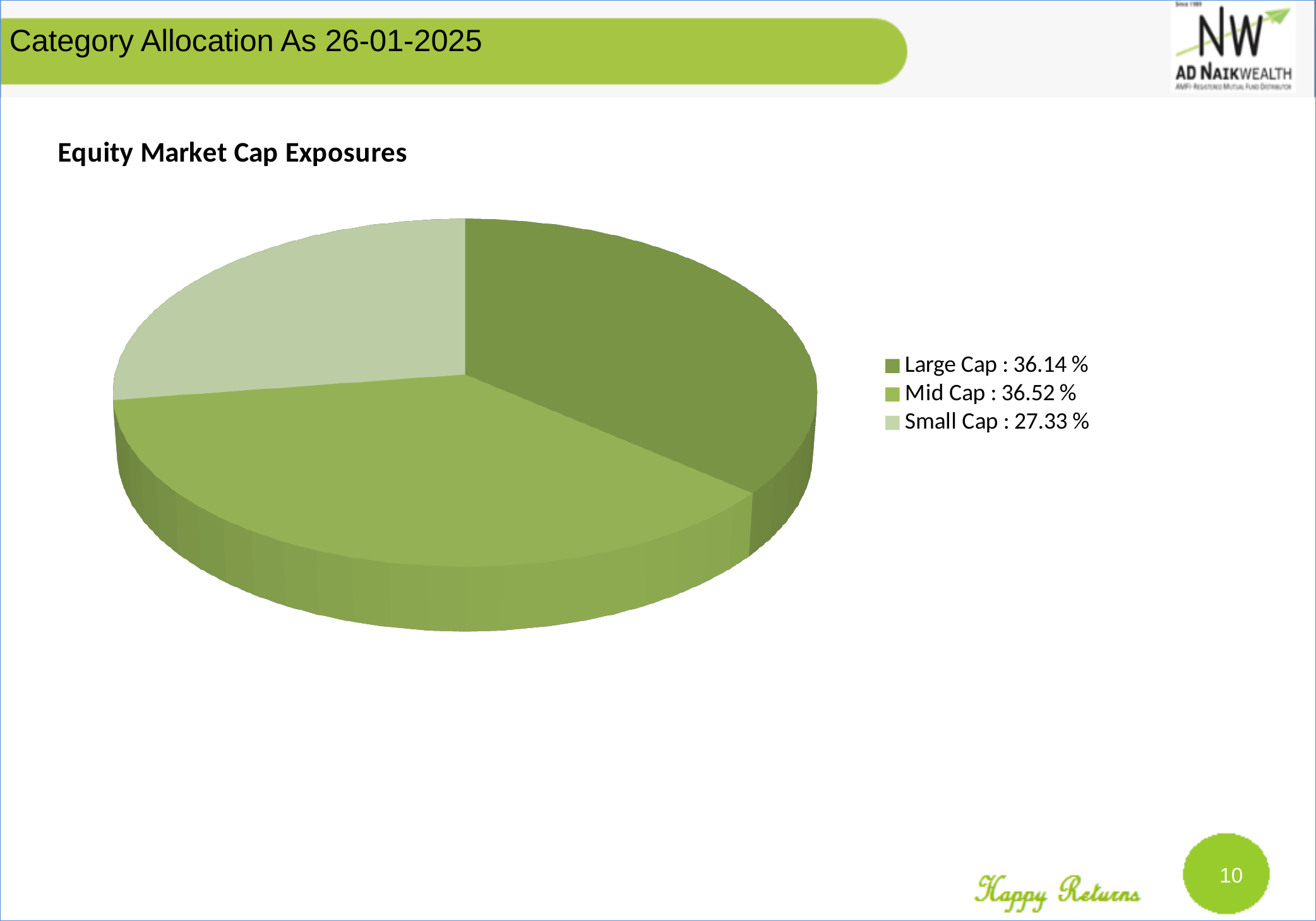
Which category has the largest share of the pie chart? Mid Cap What is the value for Mid Cap in the pie chart? 36.52 % What is the difference between the Large Cap and Small Cap values? 8.81 % Which is larger, the Large Cap value or the Small Cap value? Large Cap What is the difference between the Mid Cap and Large Cap values? 0.38 % What is the value for Large Cap in the pie chart? 36.14 % How many categories are shown in the pie chart? 3 What is the difference between the Mid Cap and Small Cap values? 9.19 % Which category has the smallest share of the pie chart? Small Cap What is the title of the chart on the slide? Equity Market Cap Exposures What is the value for Small Cap in the pie chart? 27.33 % What kind of chart is shown on the slide? Pie chart